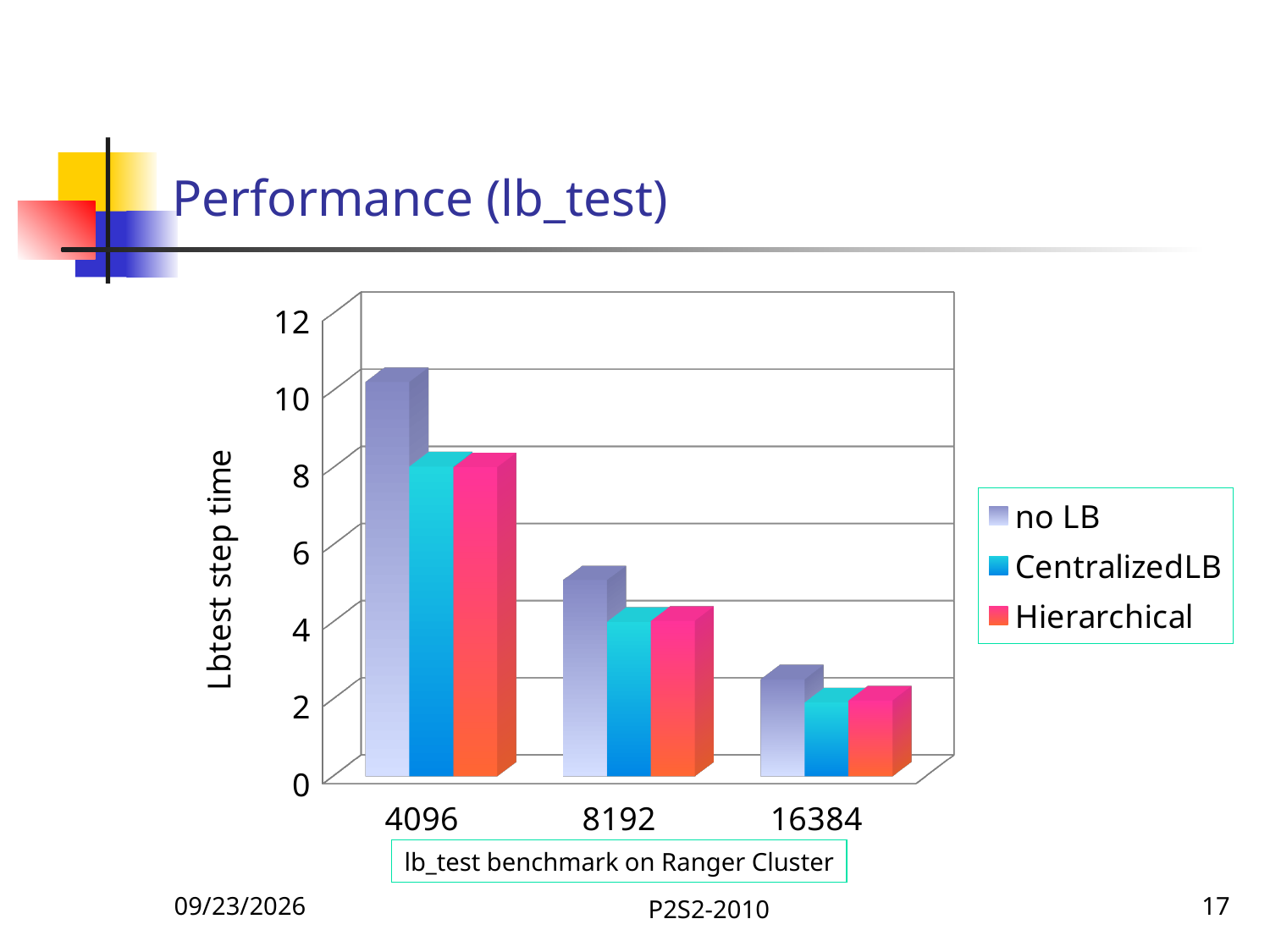
Which category has the highest value for the no LB series? 4096 How many categories are shown on the x axis? 3 What is the label on the y axis? Lbtest step time What kind of chart is shown on the slide? bar chart How many series does the legend list? 3 At 4096, which is larger: no LB or CentralizedLB? no LB Is the value for Hierarchical at 16384 greater or less than 4? less Do the values for the no LB series rise or fall as the x axis goes from 4096 to 16384? fall Is the value for CentralizedLB at 4096 greater or less than 6? greater Which category has the lowest value for the CentralizedLB series? 16384 Is the value for no LB at 8192 greater or less than 6? less